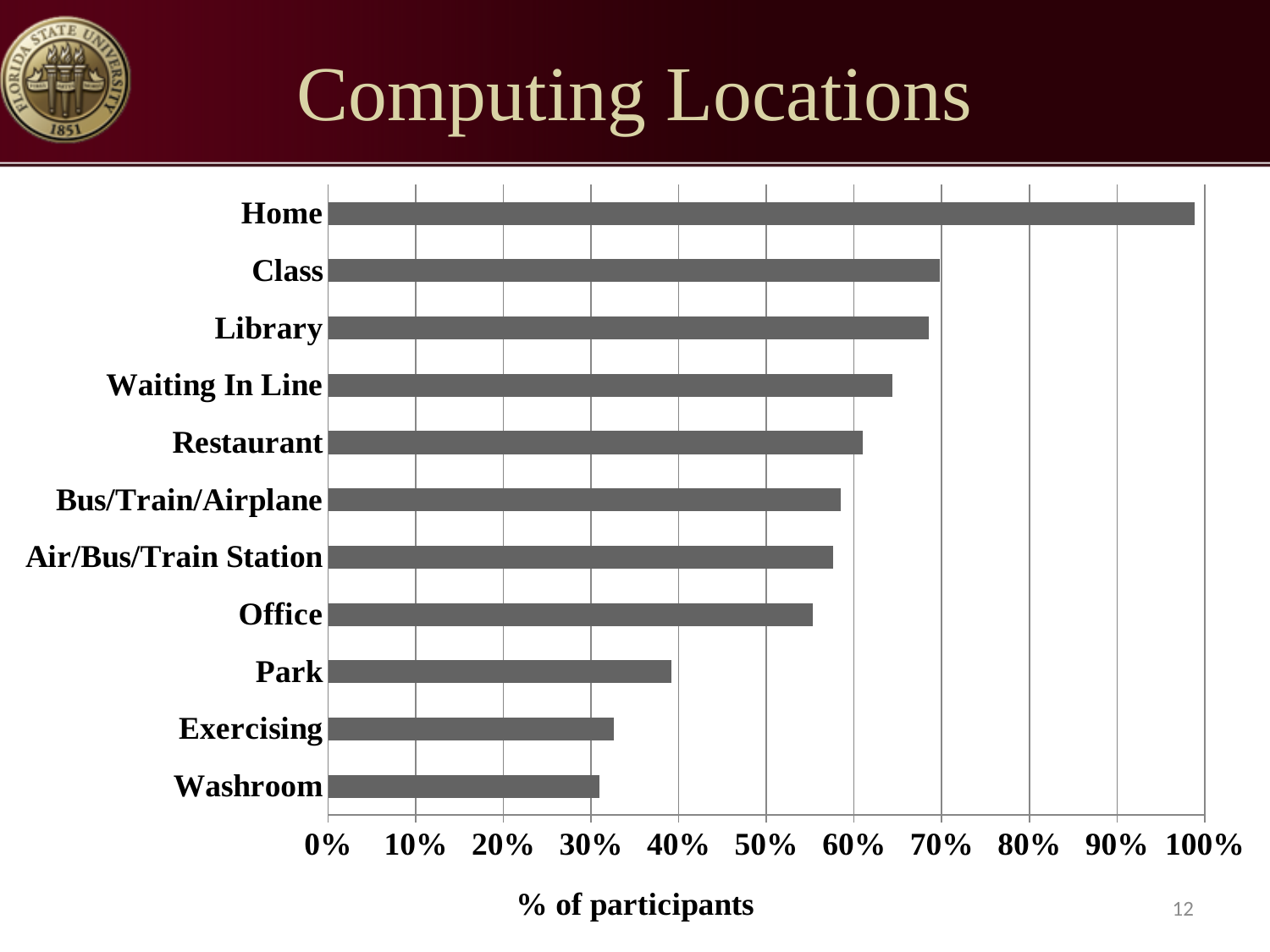
Which has a higher percentage of participants, Home or Class? Home Which computing location has the highest percentage of participants? Home Is the value for Home greater or less than 90%? greater Is the value for Office greater or less than 50%? greater How many computing locations are listed on the chart? 11 What is the label on the horizontal axis of the chart? % of participants Which has a higher percentage of participants, Park or Office? Office Is the value for Class greater or less than 80%? less What kind of chart is shown on the slide? bar chart